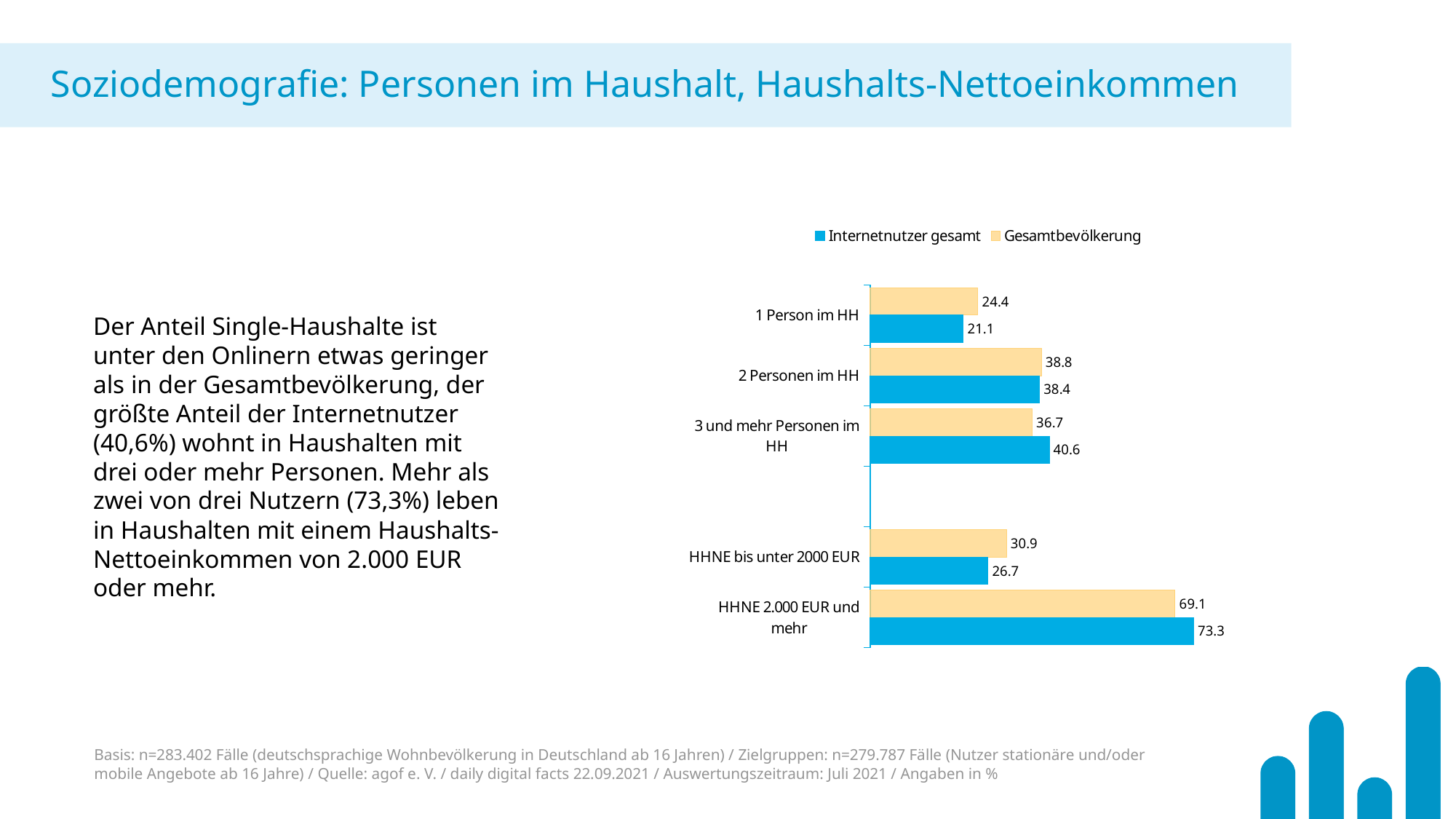
What is the value for Gesamtbevölkerung in the category 'HHNE bis unter 2000 EUR'? 30.9 Which category has the lowest value for Internetnutzer gesamt? 1 Person im HH How many categories are shown on the chart? 5 What is the value for Gesamtbevölkerung in the category '3 und mehr Personen im HH'? 36.7 In the category 'HHNE bis unter 2000 EUR', which series has the larger value: Internetnutzer gesamt or Gesamtbevölkerung? Gesamtbevölkerung What is the difference between Internetnutzer gesamt and Gesamtbevölkerung in the category 'HHNE 2.000 EUR und mehr'? 4.2 What kind of chart is shown on the slide? Bar chart How many series does the legend list? 2 In the category '3 und mehr Personen im HH', which series has the larger value: Internetnutzer gesamt or Gesamtbevölkerung? Internetnutzer gesamt What is the difference between Gesamtbevölkerung and Internetnutzer gesamt in the category '1 Person im HH'? 3.3 Which category has the highest value for Internetnutzer gesamt? HHNE 2.000 EUR und mehr What is the value for Internetnutzer gesamt in the category '1 Person im HH'? 21.1